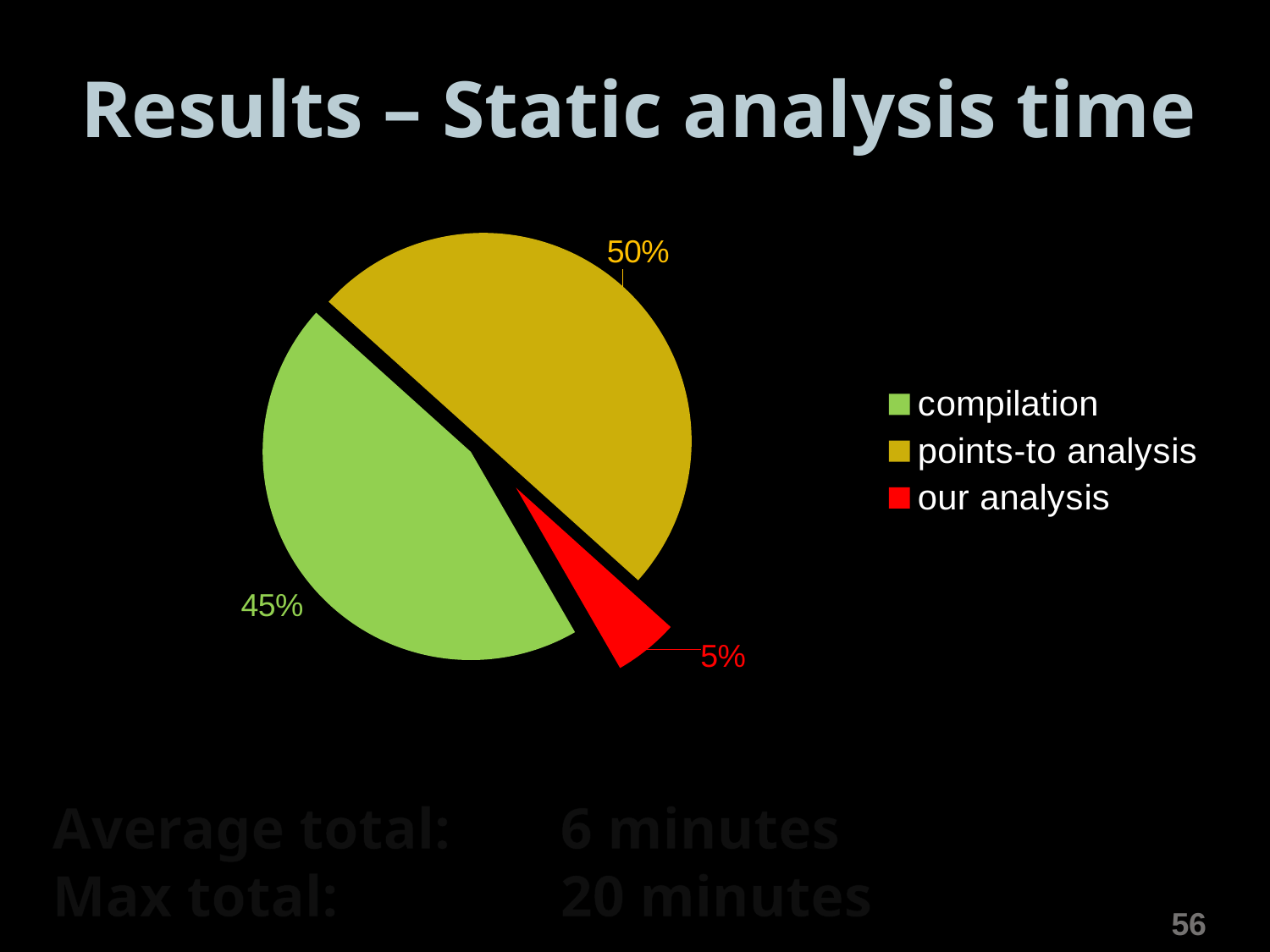
Which slice of the pie is the largest? points-to analysis What kind of chart is shown on the slide? pie chart How many slices does the pie chart have? 3 How many entries does the legend list? 3 What share of the pie does points-to analysis take? 50% What is the difference in percentage points between the compilation slice and the our analysis slice? 40% Which slice of the pie is the smallest? our analysis Which is larger, the compilation slice or the our analysis slice? compilation What is the difference in percentage points between the points-to analysis slice and the compilation slice? 5% What share of the pie does our analysis take? 5% What colour is the slice for our analysis? red What share of the pie does compilation take? 45%